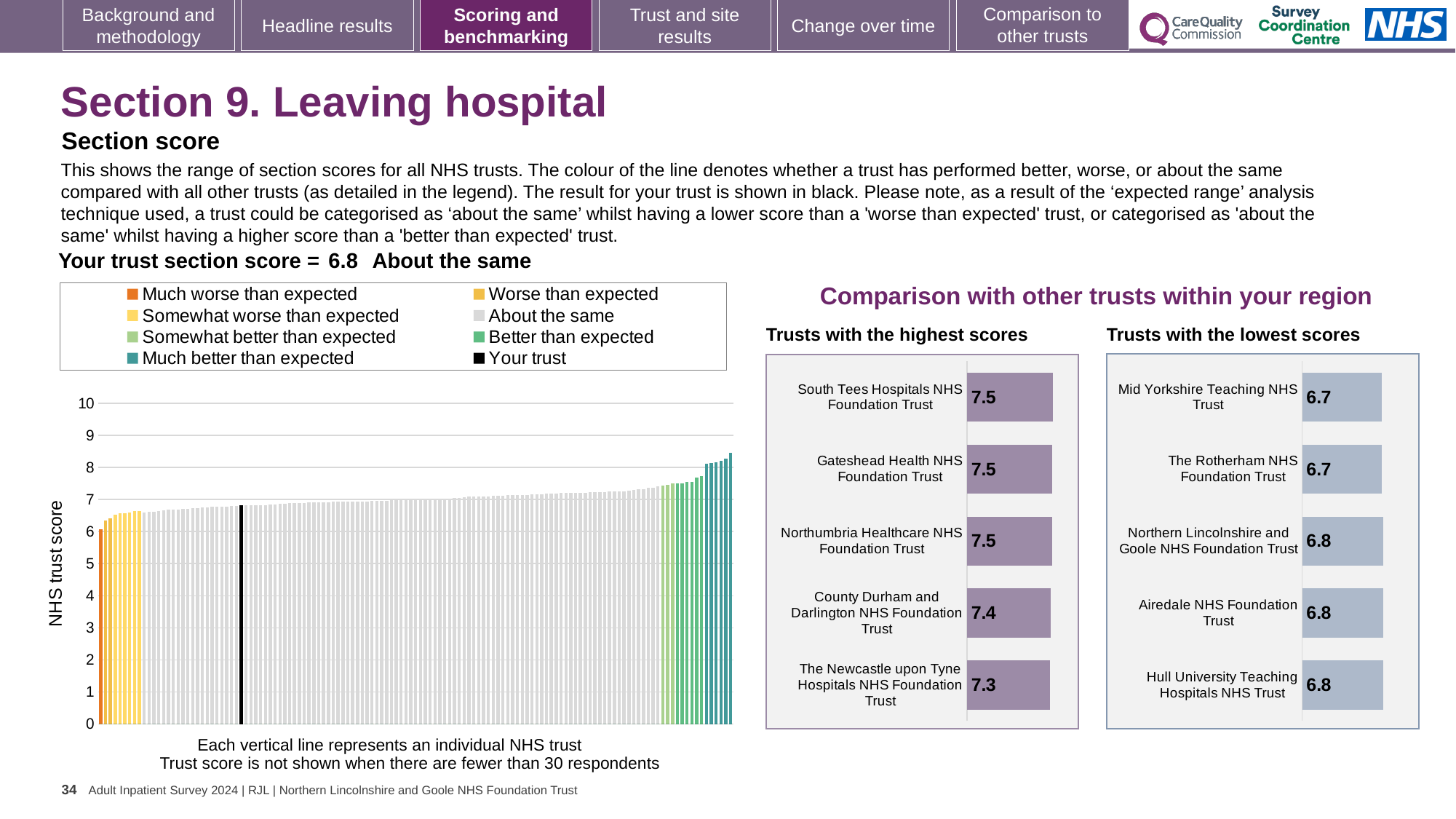
What kind of chart is the large chart on the left showing NHS trust scores? Bar chart In the 'Trusts with the highest scores' chart, which has the higher score: County Durham and Darlington NHS Foundation Trust or The Newcastle upon Tyne Hospitals NHS Foundation Trust? County Durham and Darlington NHS Foundation Trust How many entries does the legend above the large chart on the left list? 8 In the 'Trusts with the highest scores' chart, what is the score for South Tees Hospitals NHS Foundation Trust? 7.5 In the 'Trusts with the highest scores' chart, what is the difference between the scores of South Tees Hospitals NHS Foundation Trust and The Newcastle upon Tyne Hospitals NHS Foundation Trust? 0.2 In the 'Trusts with the highest scores' chart, what is the score for The Newcastle upon Tyne Hospitals NHS Foundation Trust? 7.3 In the 'Trusts with the lowest scores' chart, what is the score for Mid Yorkshire Teaching NHS Trust? 6.7 In the 'Trusts with the lowest scores' chart, how many trusts are listed? 5 In the 'Trusts with the highest scores' chart, which trust has the lowest score? The Newcastle upon Tyne Hospitals NHS Foundation Trust In the large chart on the left, do the trust scores rise or fall from left to right? Rise In the 'Trusts with the lowest scores' chart, what is the difference between the scores of Hull University Teaching Hospitals NHS Trust and Mid Yorkshire Teaching NHS Trust? 0.1 In the 'Trusts with the lowest scores' chart, what is the score for Airedale NHS Foundation Trust? 6.8